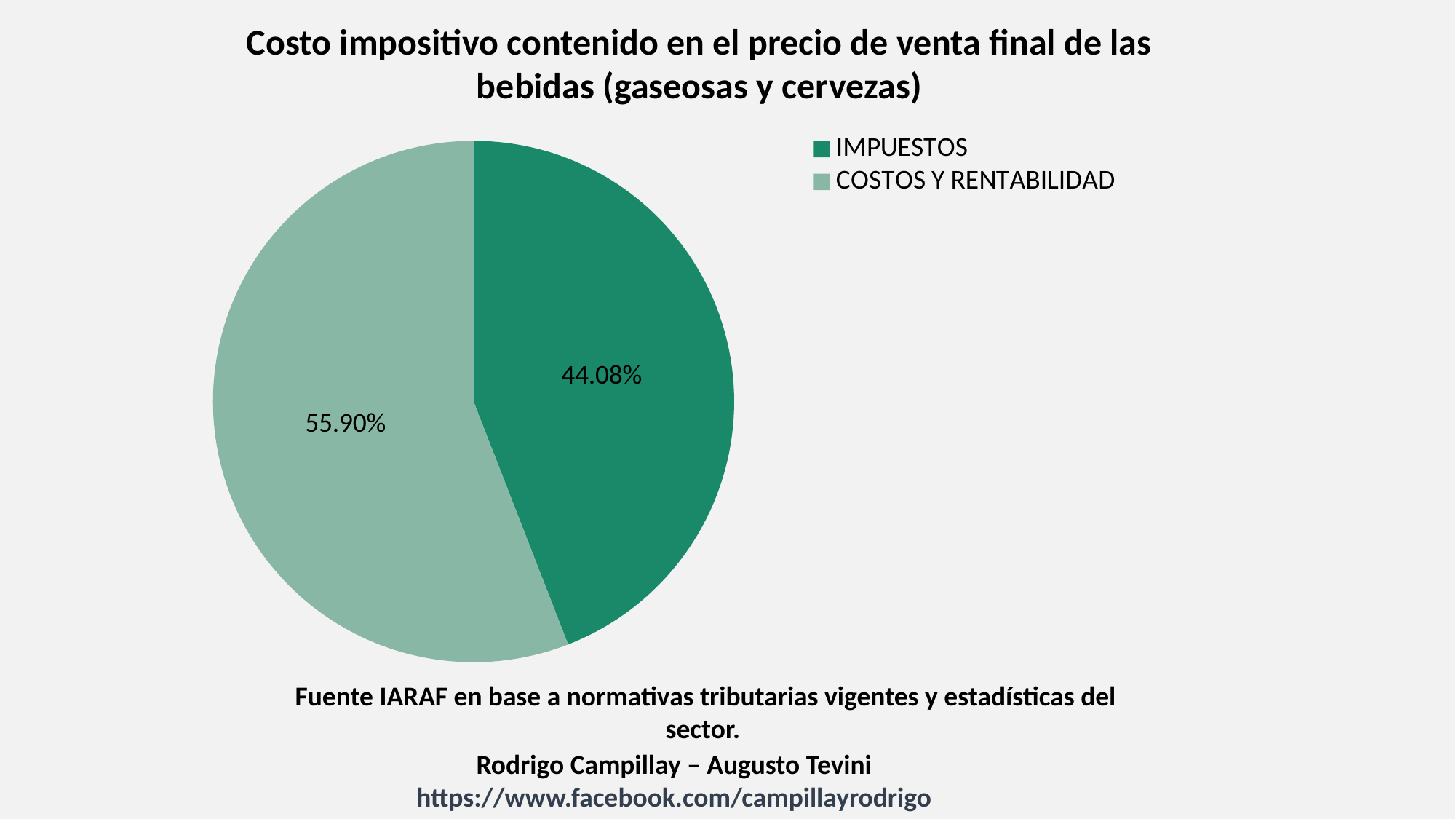
What is the difference between the COSTOS Y RENTABILIDAD and IMPUESTOS values? 11.82% What kind of chart is shown on the slide? Pie chart Which legend entry is shown in the darker green colour? IMPUESTOS Which slice is the largest? COSTOS Y RENTABILIDAD What is the value shown for COSTOS Y RENTABILIDAD? 55.90% Which slice is the smallest? IMPUESTOS How many entries does the legend list? 2 How many slices does the pie chart have? 2 What is the value shown for IMPUESTOS? 44.08% What is the title of the chart? Costo impositivo contenido en el precio de venta final de las bebidas (gaseosas y cervezas) Which is larger, IMPUESTOS or COSTOS Y RENTABILIDAD? COSTOS Y RENTABILIDAD